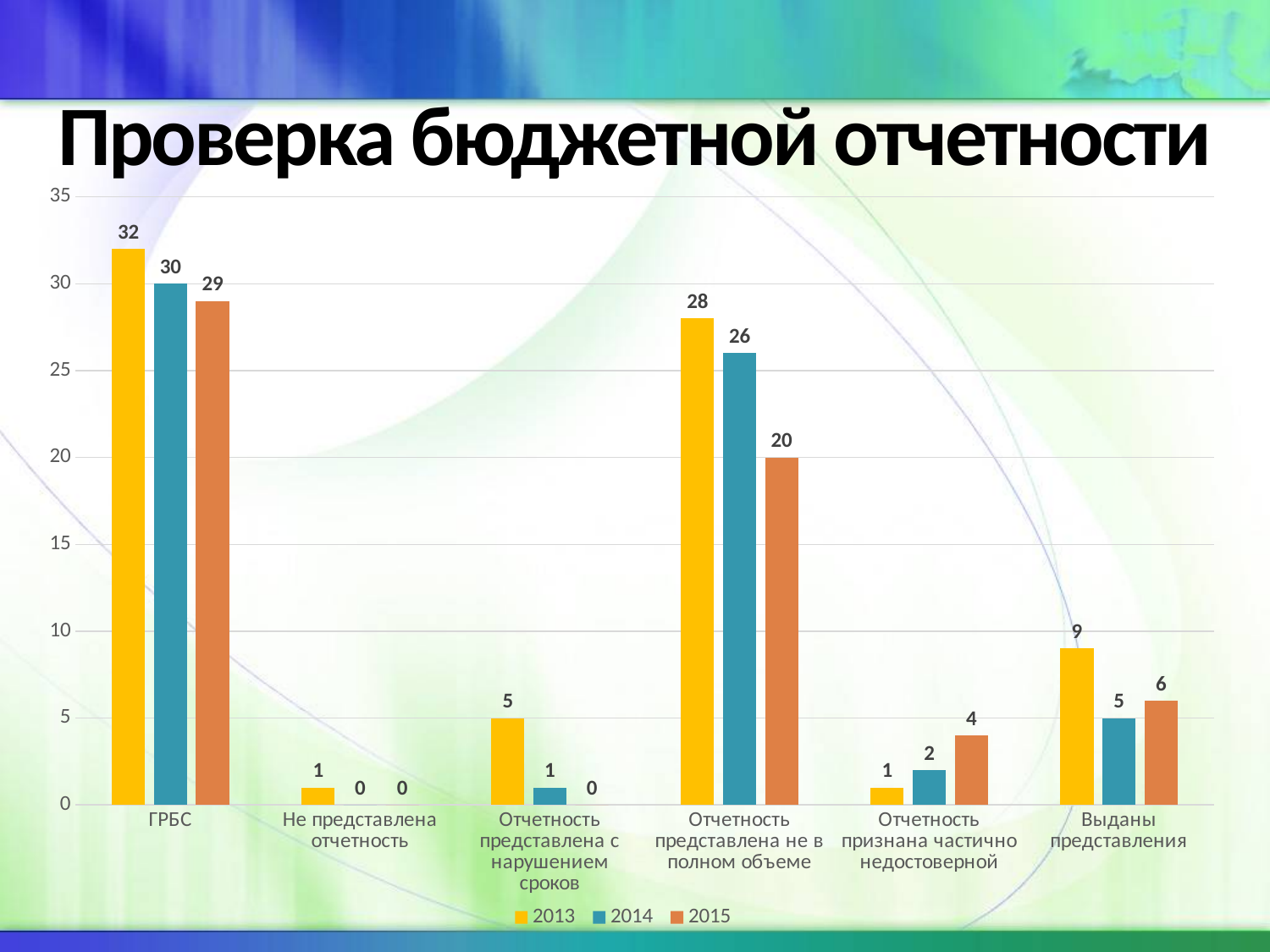
What is the value for ГРБС in 2013? 32 Do the values for ГРБС rise or fall from 2013 to 2015? fall Which is larger for Отчетность признана частично недостоверной: the 2014 value or the 2015 value? 2015 Which category has the lowest value in 2015? Не представлена отчетность and Отчетность представлена с нарушением сроков (both 0) What is the value for Выданы представления in 2014? 5 What is the title of the slide? Проверка бюджетной отчетности What is the difference between the 2013 and 2015 values for Отчетность представлена не в полном объеме? 8 How many categories are shown on the x axis? 6 What kind of chart is shown on the slide? bar chart What is the value for Отчетность представлена не в полном объеме in 2015? 20 Which category has the highest value in 2013? ГРБС How many series does the legend list? 3